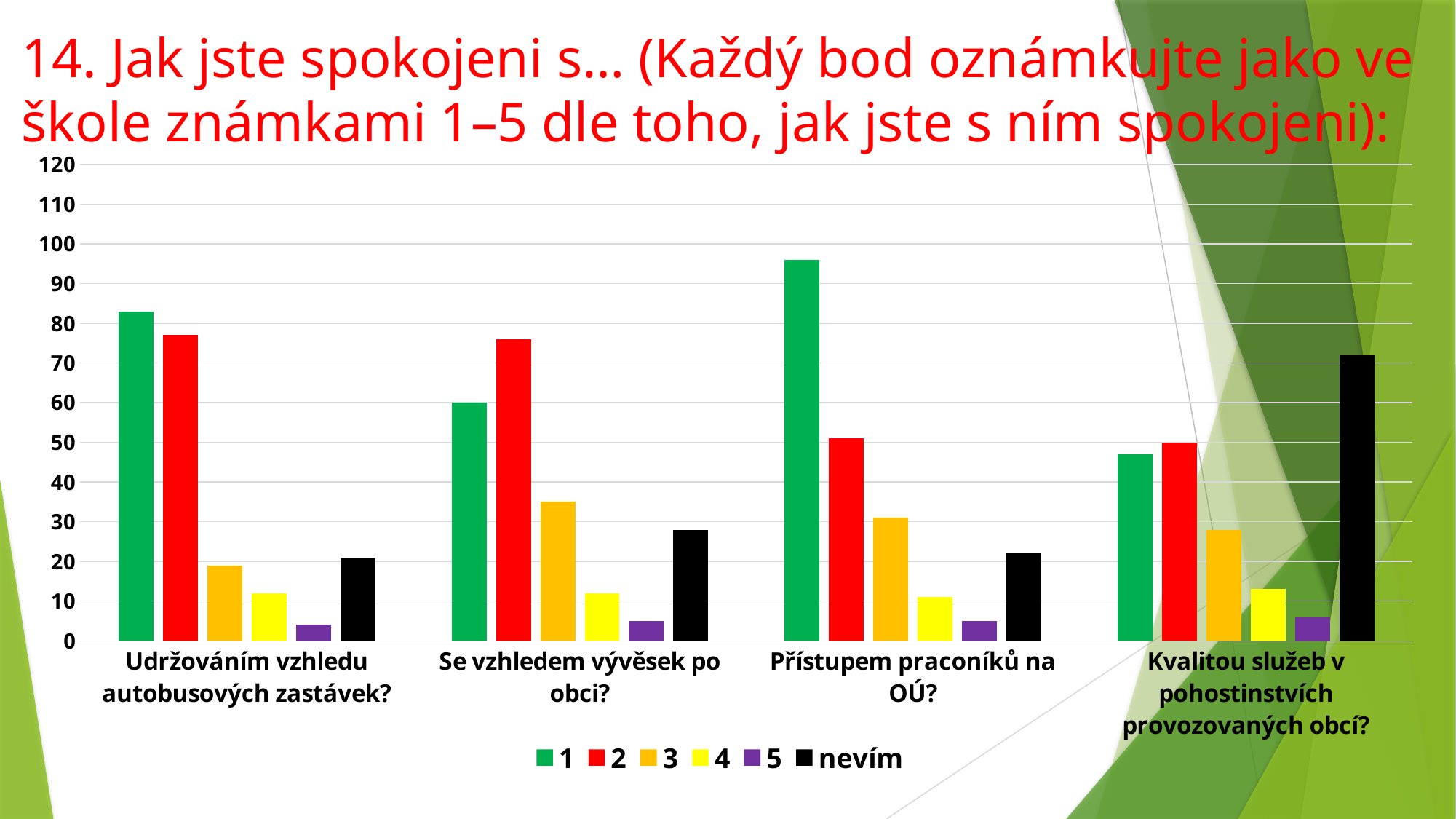
Is the value of series "3" for "Se vzhledem vývěsek po obci?" greater or less than 30? greater What colour represents the series "nevím" in the chart's legend? black For "Přístupem praconíků na OÚ?", which series has the lowest value? 5 Is the value of series "nevím" for "Kvalitou služeb v pohostinstvích provozovaných obcí?" greater or less than 60? greater What kind of chart is shown on the slide? bar chart For "Se vzhledem vývěsek po obci?", which series has the larger value, "1" or "2"? 2 Which category has the larger value for series "nevím": "Udržováním vzhledu autobusových zastávek?" or "Kvalitou služeb v pohostinstvích provozovaných obcí?"? Kvalitou služeb v pohostinstvích provozovaných obcí? How many series does the chart's legend list? 6 For which category is the value of series "1" the highest? Přístupem praconíků na OÚ? Is the value of series "1" for "Udržováním vzhledu autobusových zastávek?" greater or less than 70? greater For "Kvalitou služeb v pohostinstvích provozovaných obcí?", which series has the highest value? nevím How many categories are shown along the x axis of the chart? 4